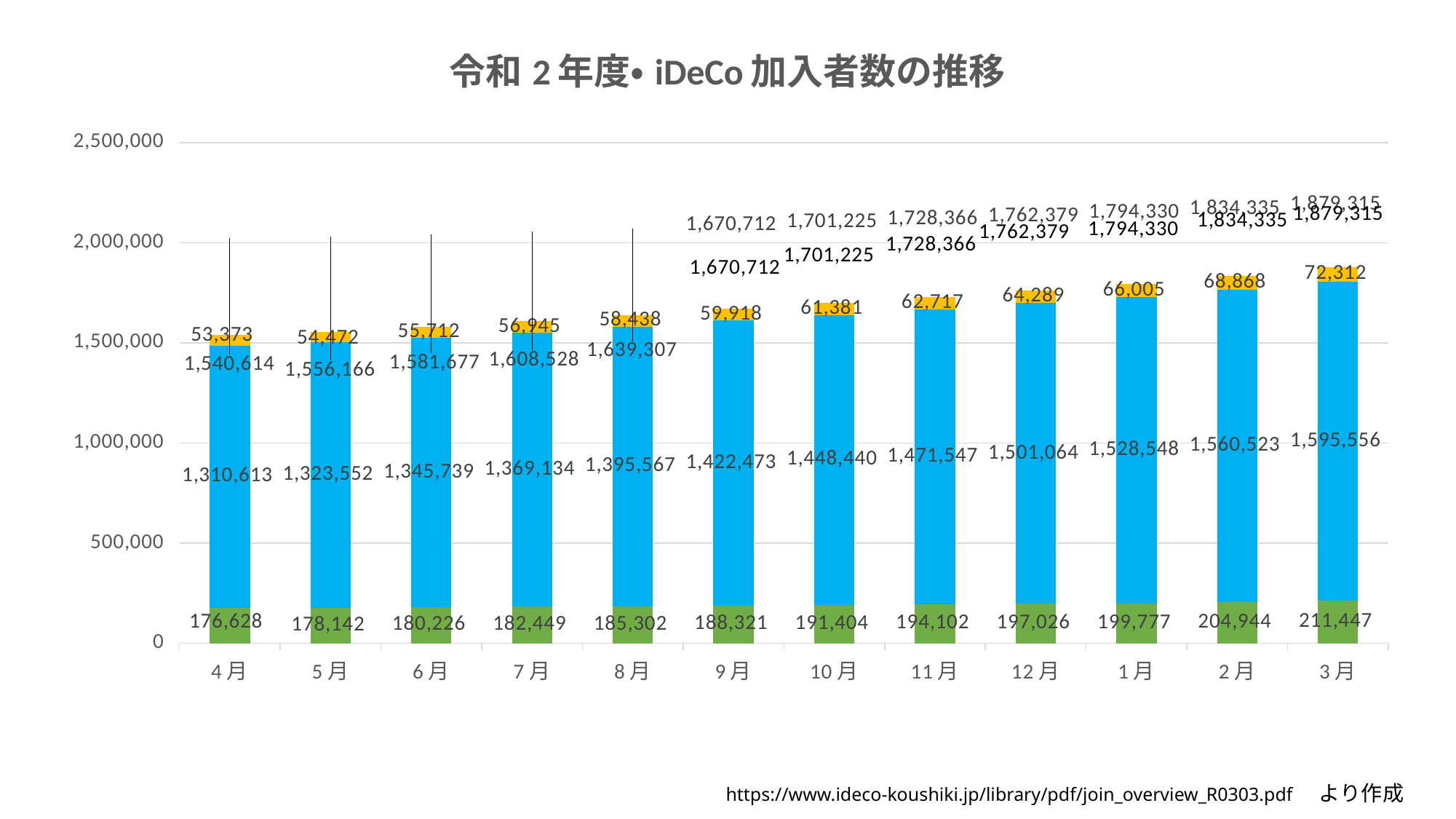
What kind of chart is this? Stacked bar chart What is the difference between the total for 3月 and the total for 4月? 338,701 How many months are shown on the x axis? 12 What is the value of the orange (top) segment for 8月? 58,438 Which is larger, the green segment for 2月 or the green segment for 1月? 2月 What is the total value labelled above the bar for 3月? 1,879,315 Which month has the lowest total? 4月 Do the totals rise or fall from 4月 to 3月? Rise Which month has the highest total? 3月 What is the value of the blue segment for 4月? 1,310,613 What is the value of the green (bottom) segment for 10月? 191,404 Is the total for 9月 greater or less than 1,500,000? greater